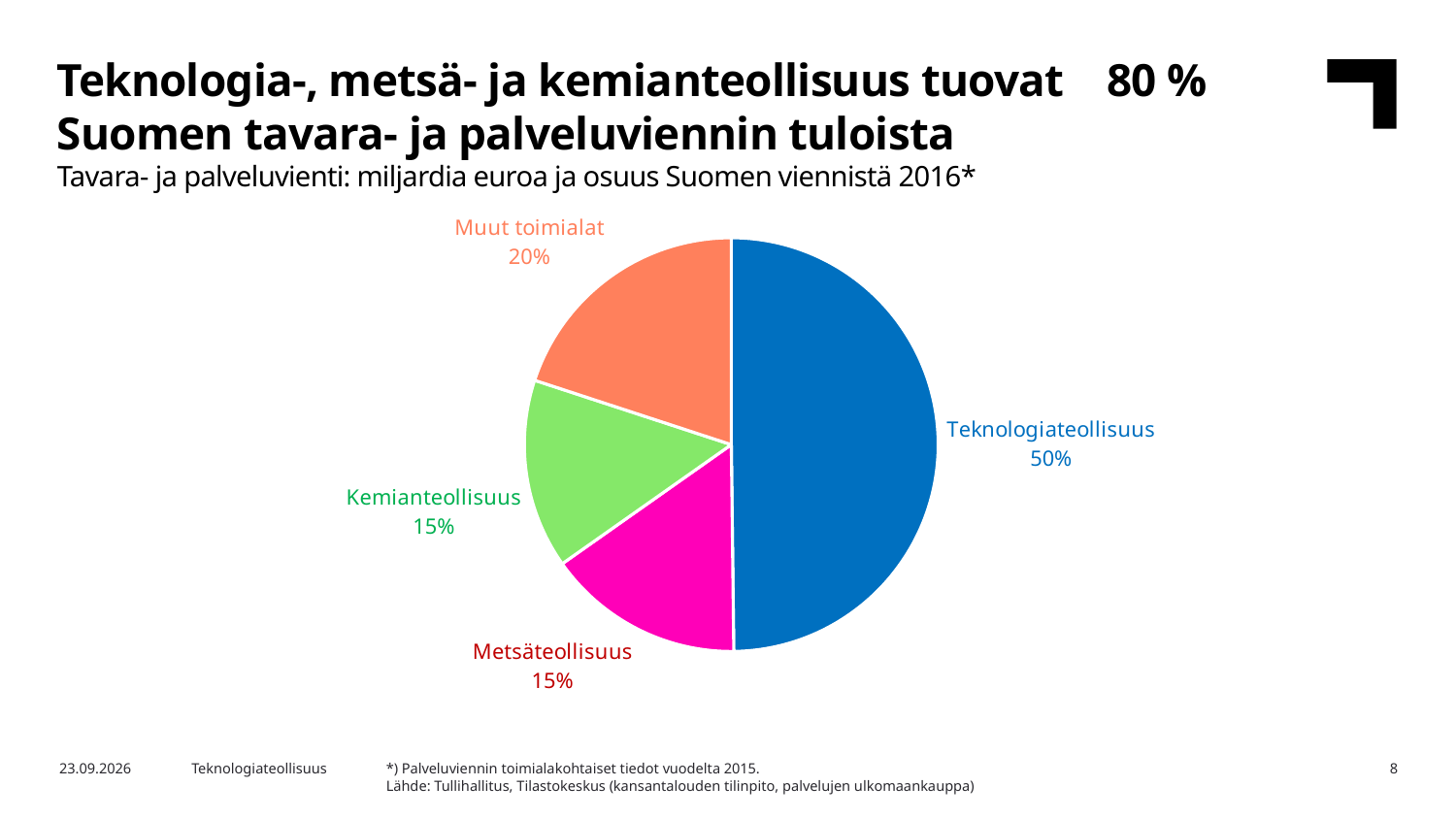
Which is larger, the share for Muut toimialat or the share for Kemianteollisuus? Muut toimialat What is the value shown for Kemianteollisuus? 15% What share of the pie does Muut toimialat have? 20% What is the subtitle of the chart on the slide? Tavara- ja palveluvienti: miljardia euroa ja osuus Suomen viennistä 2016* What colour is the Teknologiateollisuus slice? blue What is the value shown for Metsäteollisuus? 15% What is the combined share of Teknologiateollisuus, Metsäteollisuus and Kemianteollisuus? 80% What kind of chart is shown on the slide? pie chart How many slices does the pie chart have? 4 What is the difference in percentage points between Teknologiateollisuus and Muut toimialat? 30 percentage points Which slice of the pie is the largest? Teknologiateollisuus What share of the pie does Teknologiateollisuus have? 50%